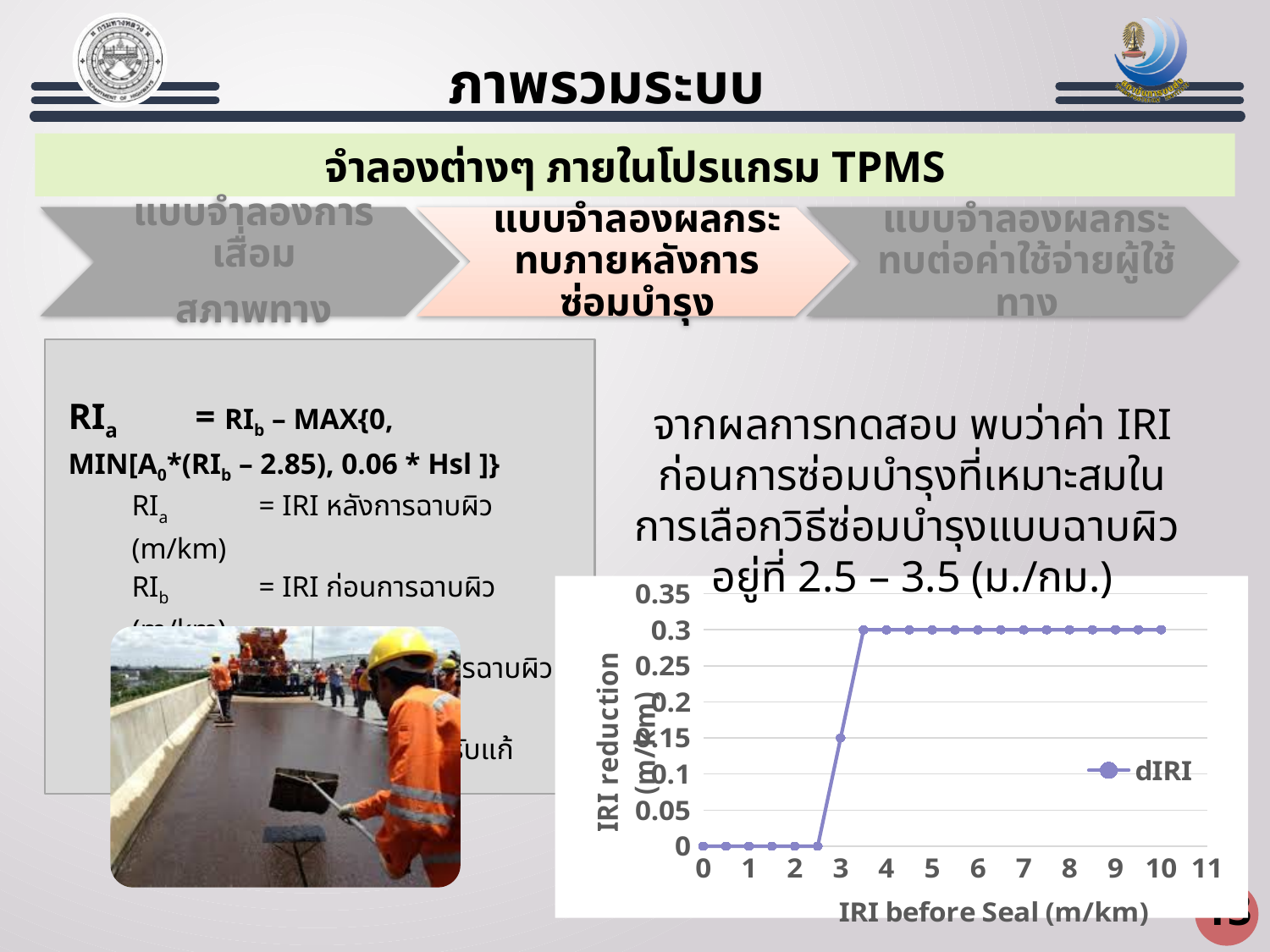
What is the name of the series shown in the chart legend? dIRI Does the IRI reduction value rise or fall as IRI before Seal increases from 0 to 10? rise What kind of chart is shown at the bottom right of the slide? line chart What is the IRI reduction value when IRI before Seal is 5 m/km? 0.3 Which has the larger IRI reduction value: IRI before Seal of 2 m/km or 4 m/km? 4 m/km What is the IRI reduction value when IRI before Seal is 3 m/km? 0.15 What is the IRI reduction value when IRI before Seal is 1 m/km? 0 Is the IRI reduction value at IRI before Seal of 8 m/km greater or less than 0.2? greater What is the lowest IRI reduction value in the dIRI series? 0 What is the title of the x axis of the chart? IRI before Seal (m/km) How many series does the legend of the chart list? 1 What is the highest IRI reduction value reached by the dIRI series? 0.3